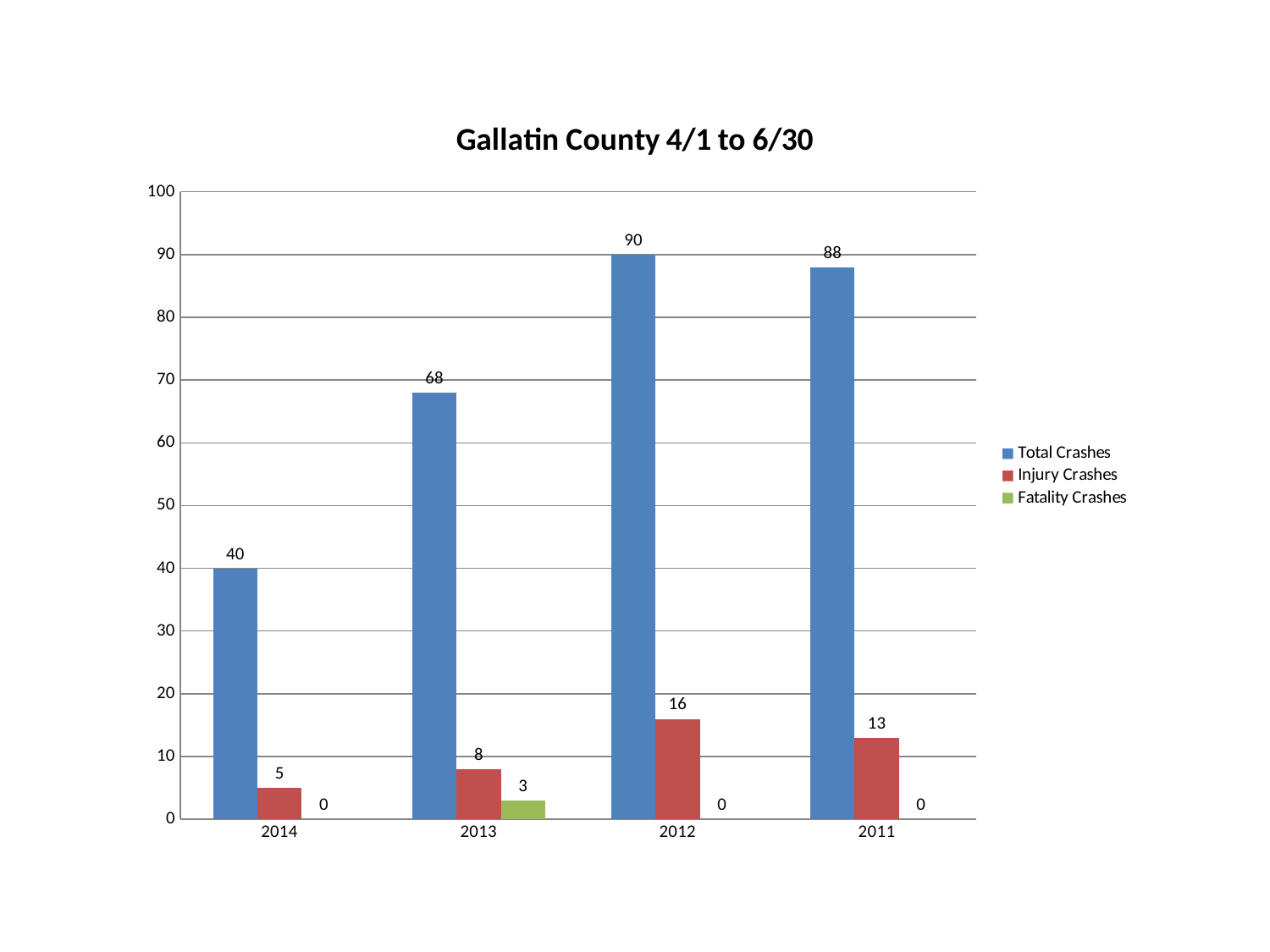
What kind of chart is shown? bar chart Which year has the lowest Injury Crashes? 2014 What is the title of the chart? Gallatin County 4/1 to 6/30 What is the value of Total Crashes for 2012? 90 How many years are shown on the x axis? 4 How many series does the legend list? 3 What is the value of Injury Crashes for 2011? 13 What is the difference between Total Crashes in 2012 and 2014? 50 What is the value of Fatality Crashes for 2013? 3 Is the value of Total Crashes for 2013 greater or less than 60? greater Which year has the highest Total Crashes? 2012 Which is larger, Injury Crashes in 2012 or Injury Crashes in 2013? 2012